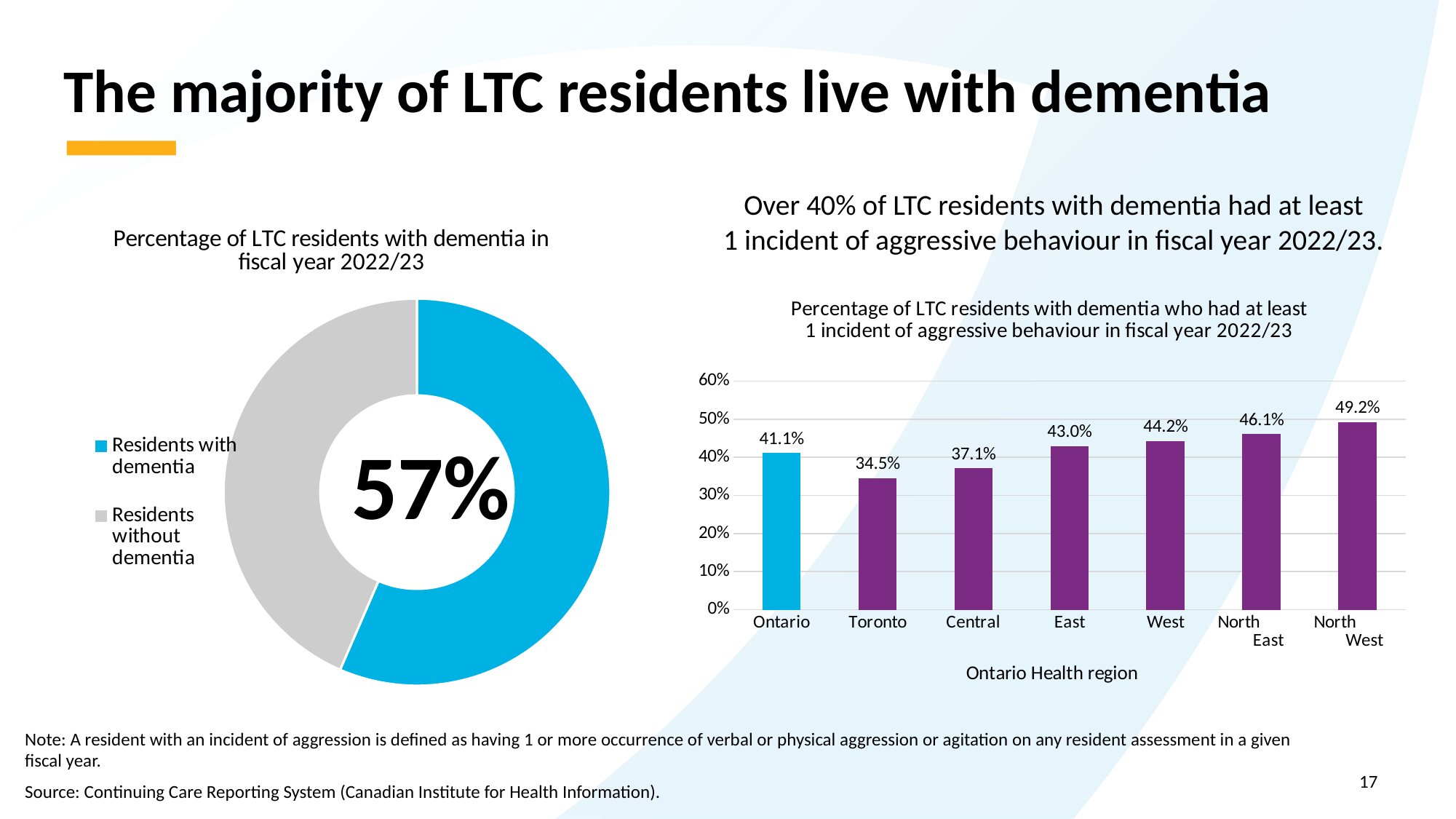
In the doughnut chart on the left, what share of LTC residents have dementia? 57% In the bar chart on the right, which region has the highest percentage? North West In the bar chart on the right, what is the value for Toronto? 34.5% What is the x-axis title of the bar chart on the right? Ontario Health region In the bar chart on the right, what is the value for Ontario? 41.1% In the bar chart on the right, which region has the lowest percentage? Toronto In the bar chart on the right, how many regions are shown on the x axis? 7 In the bar chart on the right, what is the value for North West? 49.2% In the bar chart on the right, which is larger, the value for East or the value for Central? East How many categories does the legend of the doughnut chart on the left list? 2 What kind of chart is on the right side of the slide? Bar chart In the bar chart on the right, what is the difference between North West and Toronto? 14.7%